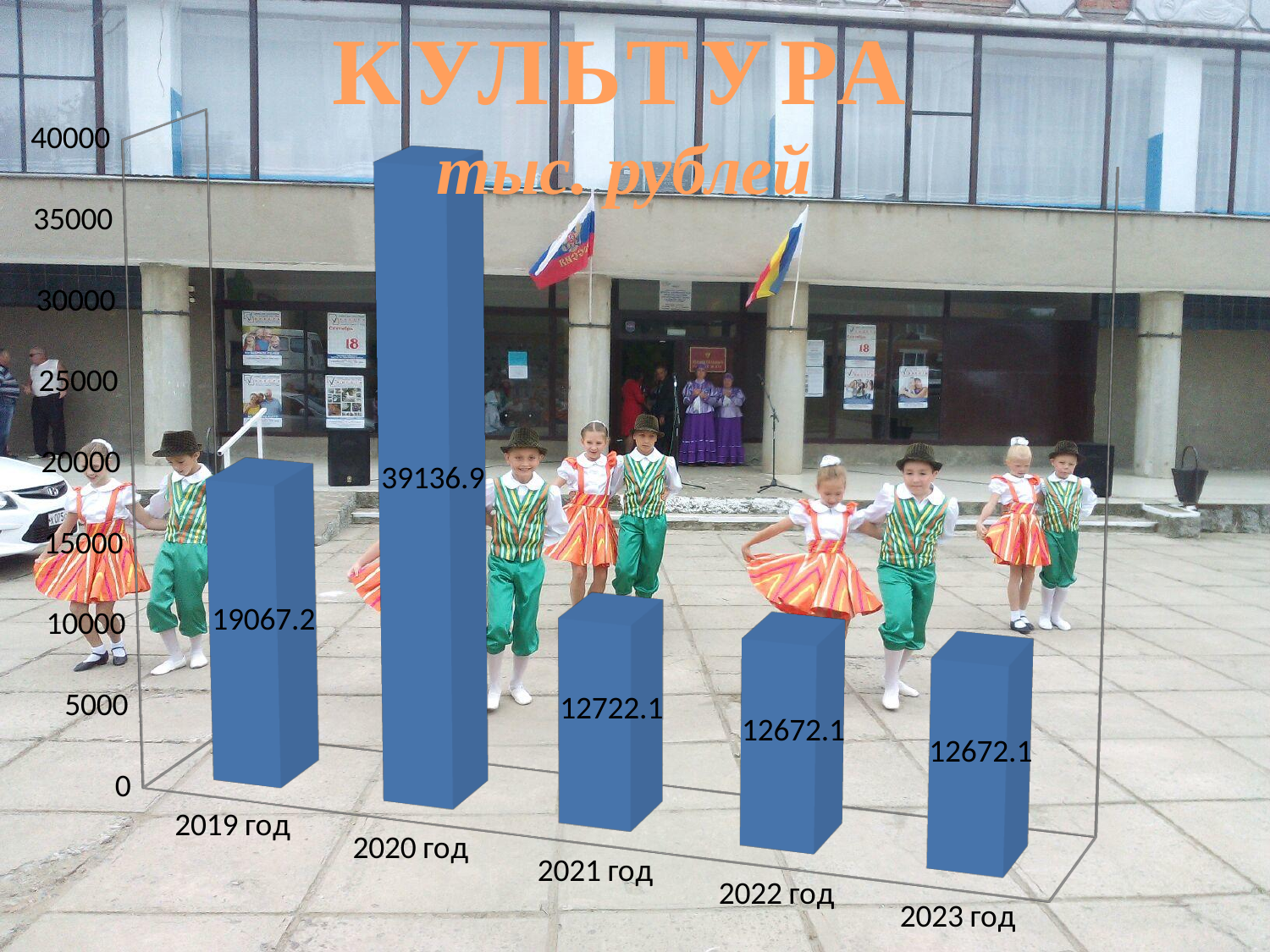
What is the title of the chart? КУЛЬТУРА Is the value for 2020 год greater or less than 35000? greater Which is larger, the value for 2019 год or the value for 2021 год? 2019 год What is the difference between the values for 2021 год and 2022 год? 50 Which year has the highest value? 2020 год What is the value for 2020 год? 39136.9 What kind of chart is shown on the slide? bar chart What is the value for 2023 год? 12672.1 What is the value for 2021 год? 12722.1 What is the value for 2019 год? 19067.2 How many years are shown on the chart? 5 What is the difference between the values for 2020 год and 2019 год? 20069.7